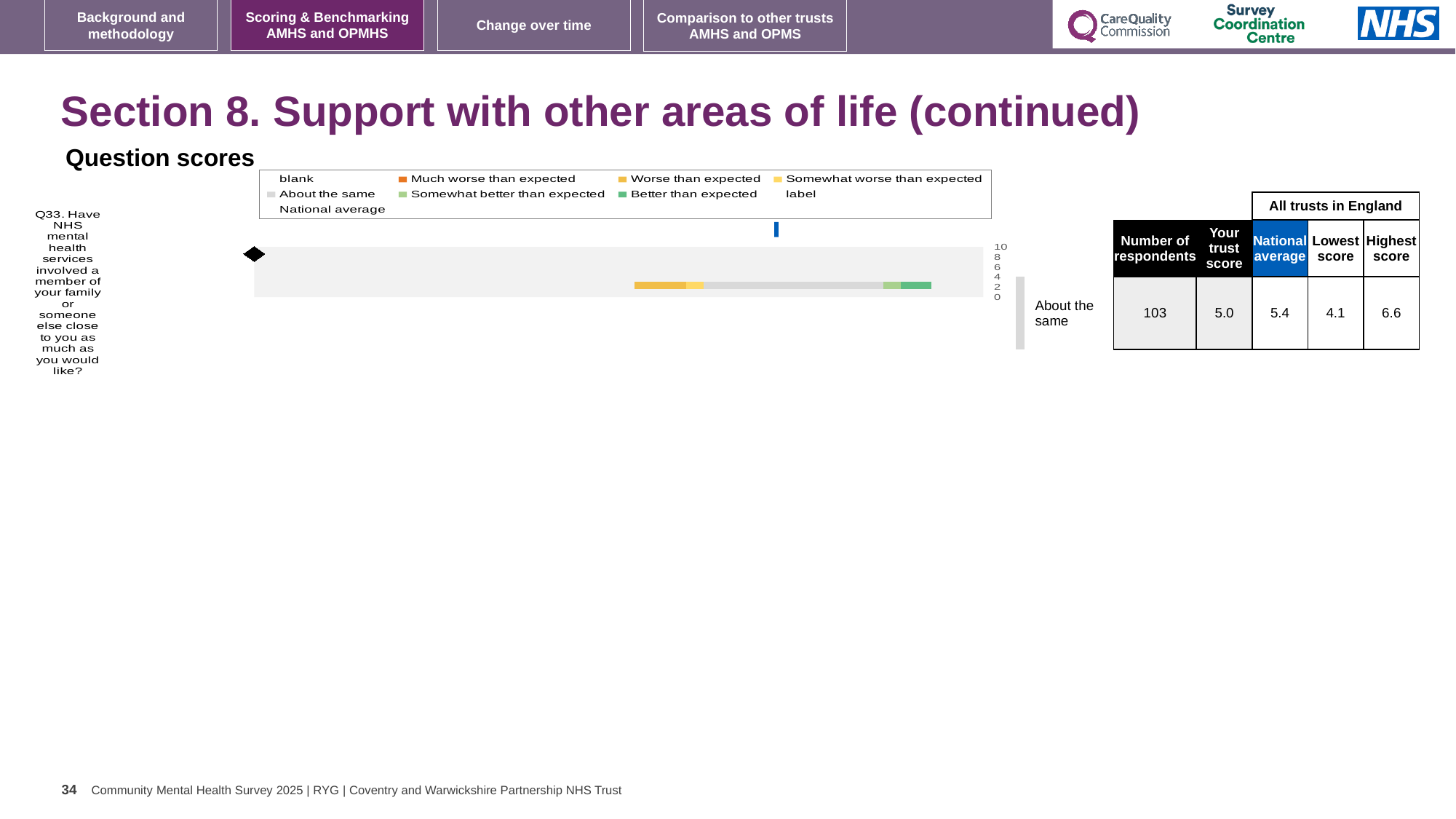
Which question number is plotted in the chart? Q33 In the table beside the chart, what is the difference between the highest score and the lowest score for Q33? 2.5 How many survey questions are plotted in the chart? 1 In the table beside the chart, what is the national average for Q33? 5.4 In the table beside the chart, what is the highest score among all trusts in England for Q33? 6.6 What colour does the legend use for 'Better than expected'? green In the table beside the chart, what is the number of respondents for Q33? 103 In the table beside the chart, what is 'Your trust score' for Q33? 5.0 What kind of chart is shown under 'Question scores'? bar chart In the table beside the chart, which is larger for Q33: your trust score or the national average? national average What rating is shown to the right of the chart for Q33? About the same In the table beside the chart, what is the lowest score among all trusts in England for Q33? 4.1